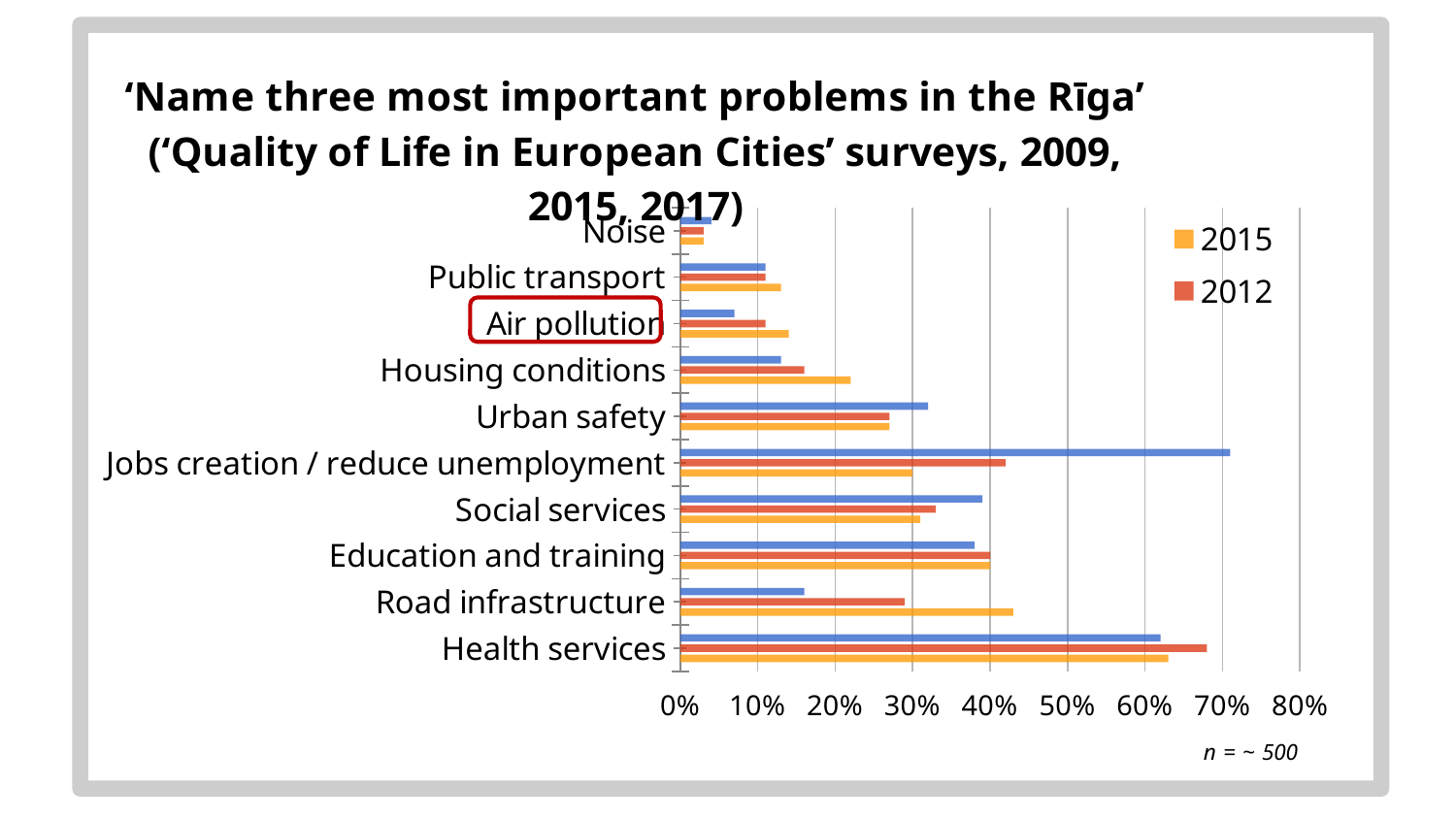
How many series does the chart's legend list? 2 For Road infrastructure, which series has the larger value, 2015 or 2012? 2015 Is the 2015 value for Noise greater or less than 10%? less Is the 2015 value for Health services greater or less than 60%? greater What kind of chart is shown on the slide? Bar chart How many problem categories are listed on the chart's vertical axis? 10 Is the 2015 value for Road infrastructure greater or less than 40%? greater For Housing conditions, which series has the larger value, 2015 or 2012? 2015 Which category has the lowest value for the 2012 series? Noise Which category has the highest value for the 2015 series? Health services